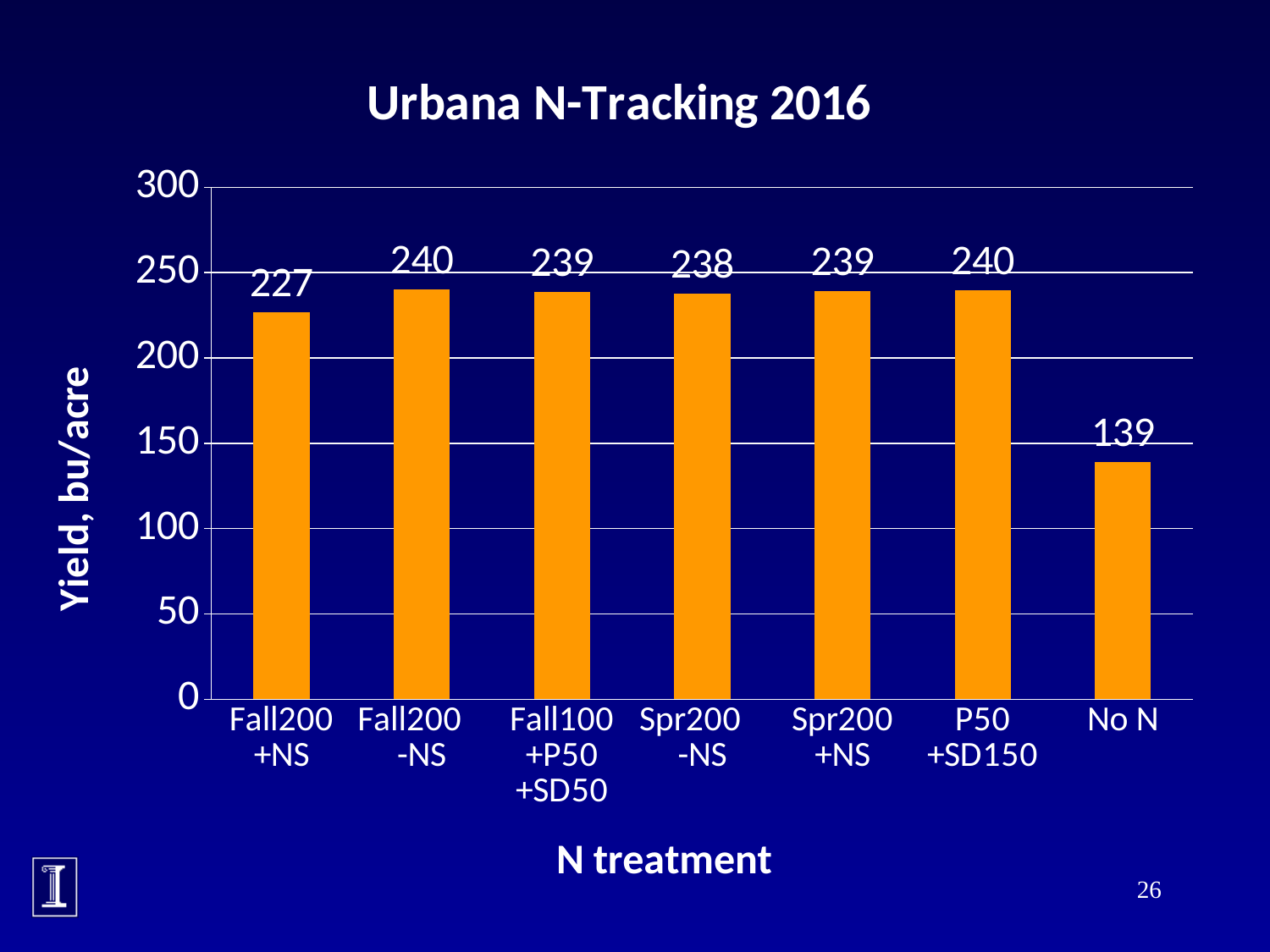
What kind of chart is shown on the slide? bar chart What is the difference in yield between Fall200 -NS and Fall200 +NS? 13 Which has the larger yield, Fall200 +NS or Spr200 +NS? Spr200 +NS How many N treatments are shown on the chart? 7 What is the title of the chart? Urbana N-Tracking 2016 What is the yield for the Fall100 +P50 +SD50 treatment? 239 What is the yield for the Spr200 -NS treatment? 238 Is the yield for No N greater or less than 150? less Which N treatment has the lowest yield? No N What is the yield for the Fall200 +NS treatment? 227 What is the difference in yield between Fall200 -NS and No N? 101 What is the yield for the No N treatment? 139